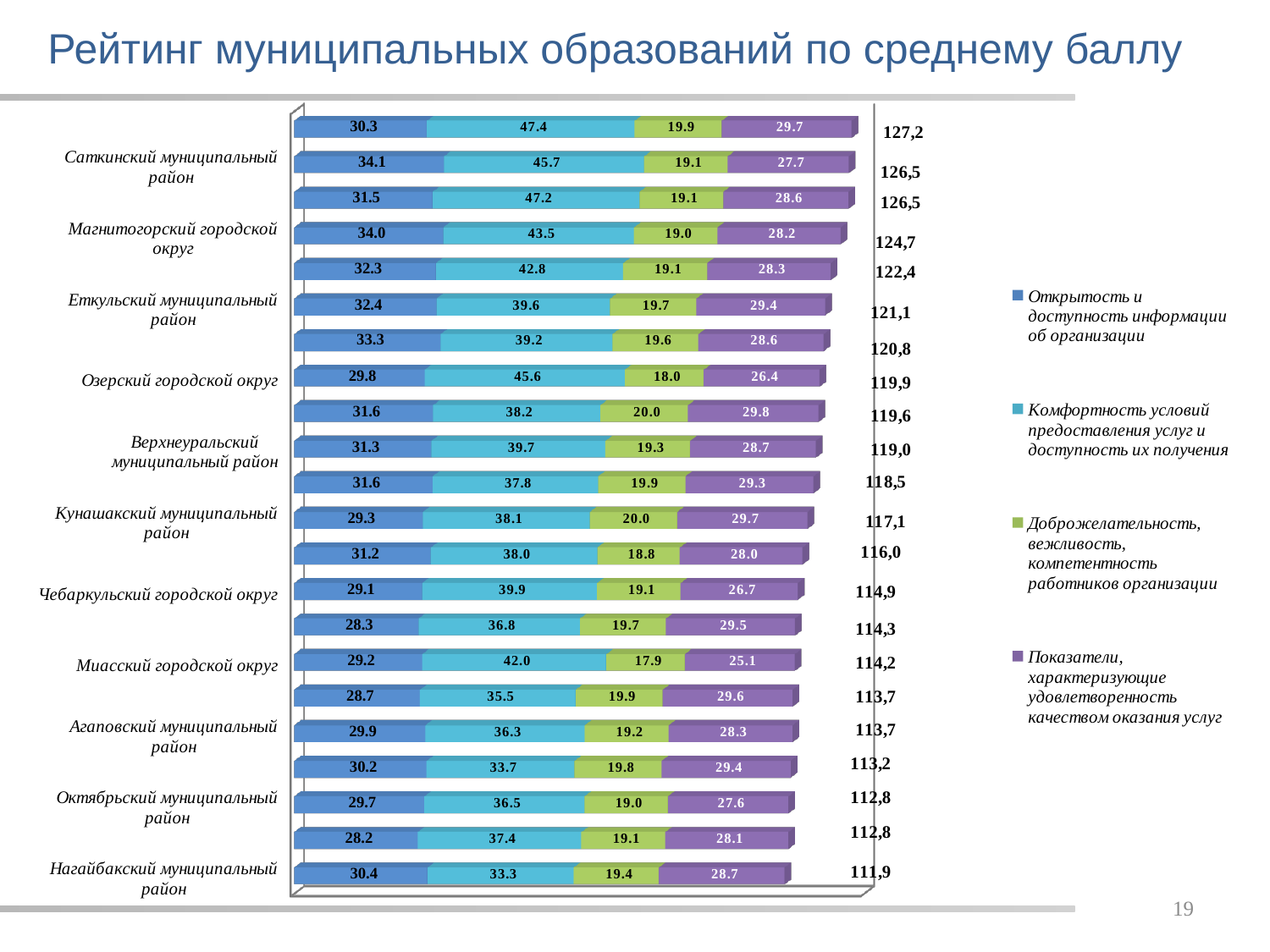
Which colour represents 'Показатели, характеризующие удовлетворенность качеством оказания услуг' in the legend? Purple What type of chart is shown on the slide? Stacked bar chart Which has a higher value for 'Комфортность условий предоставления услуг и доступность их получения': Озерский городской округ or Миасский городской округ? Озерский городской округ How many series does the legend list? 4 What is the difference between the total score of Саткинский муниципальный район (126,5) and Нагайбакский муниципальный район (111,9)? 14,6 What is the highest total score shown in the chart? 127,2 Do the total scores increase or decrease going from the top bar to the bottom bar? Decrease What is the total score shown for Нагайбакский муниципальный район? 111,9 What is the value of 'Комфортность условий предоставления услуг и доступность их получения' for Саткинский муниципальный район? 45.7 What is the value of 'Открытость и доступность информации об организации' for Магнитогорский городской округ? 34.0 How many bars are plotted in the chart? 22 What is the lowest total score shown in the chart? 111,9